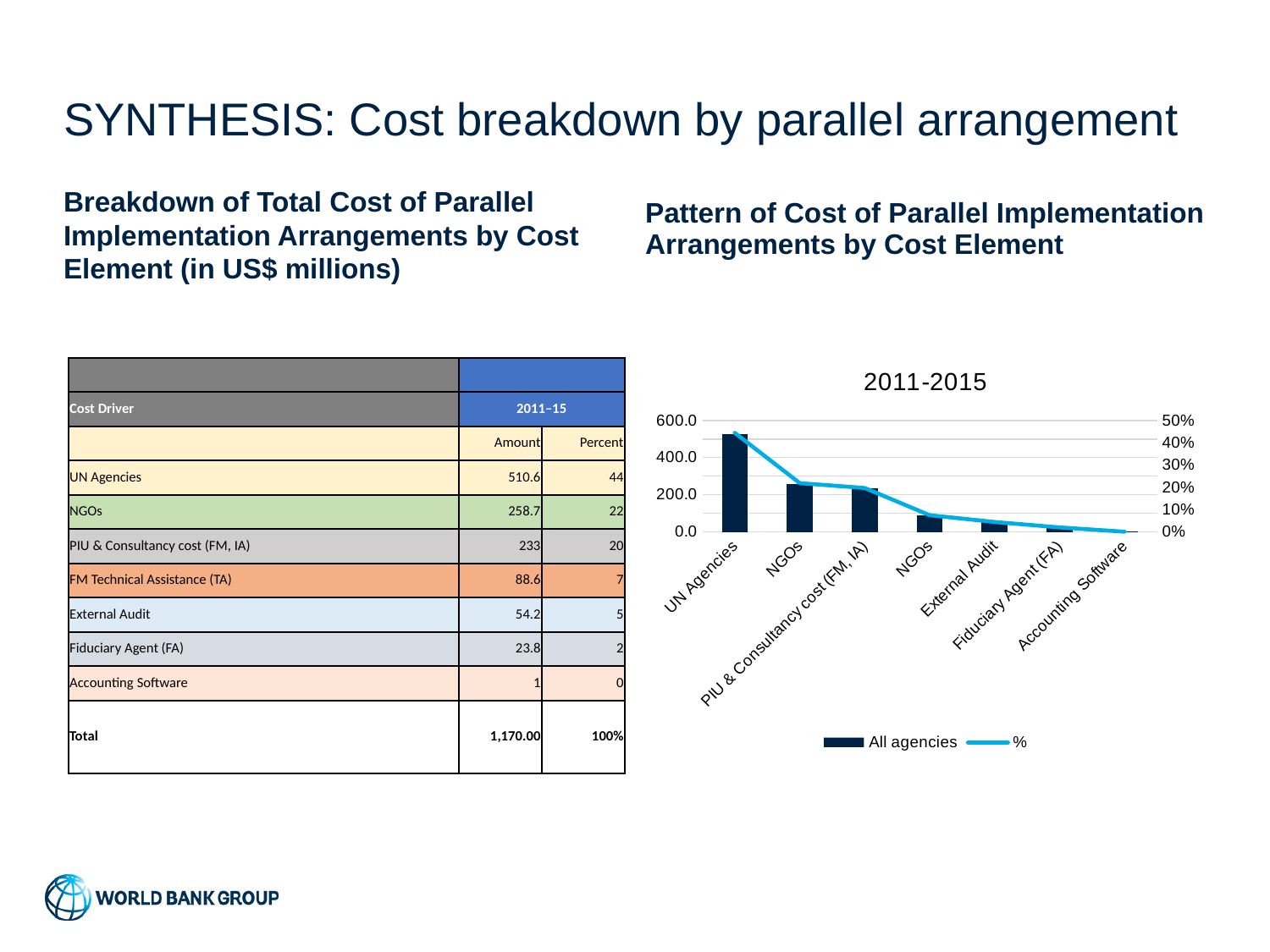
What kind of chart is shown under the title "2011-2015"? A bar chart with a line overlay How many series does the legend of the "2011-2015" chart list? 2 In the "2011-2015" chart, is the bar for External Audit greater or less than 200.0? less In the "2011-2015" chart, is the % line value for UN Agencies greater or less than 40%? greater Which category has the shortest bar in the "2011-2015" chart? Accounting Software Which category has the tallest bar in the "2011-2015" chart? UN Agencies In the "2011-2015" chart, which bar is taller: UN Agencies or External Audit? UN Agencies What are the two legend entries of the "2011-2015" chart? All agencies and % How many categories are shown on the x axis of the "2011-2015" chart? 7 In the "2011-2015" chart, is the bar for Accounting Software greater or less than 200.0? less Do the bar values in the "2011-2015" chart rise or fall from left to right along the x axis? Fall